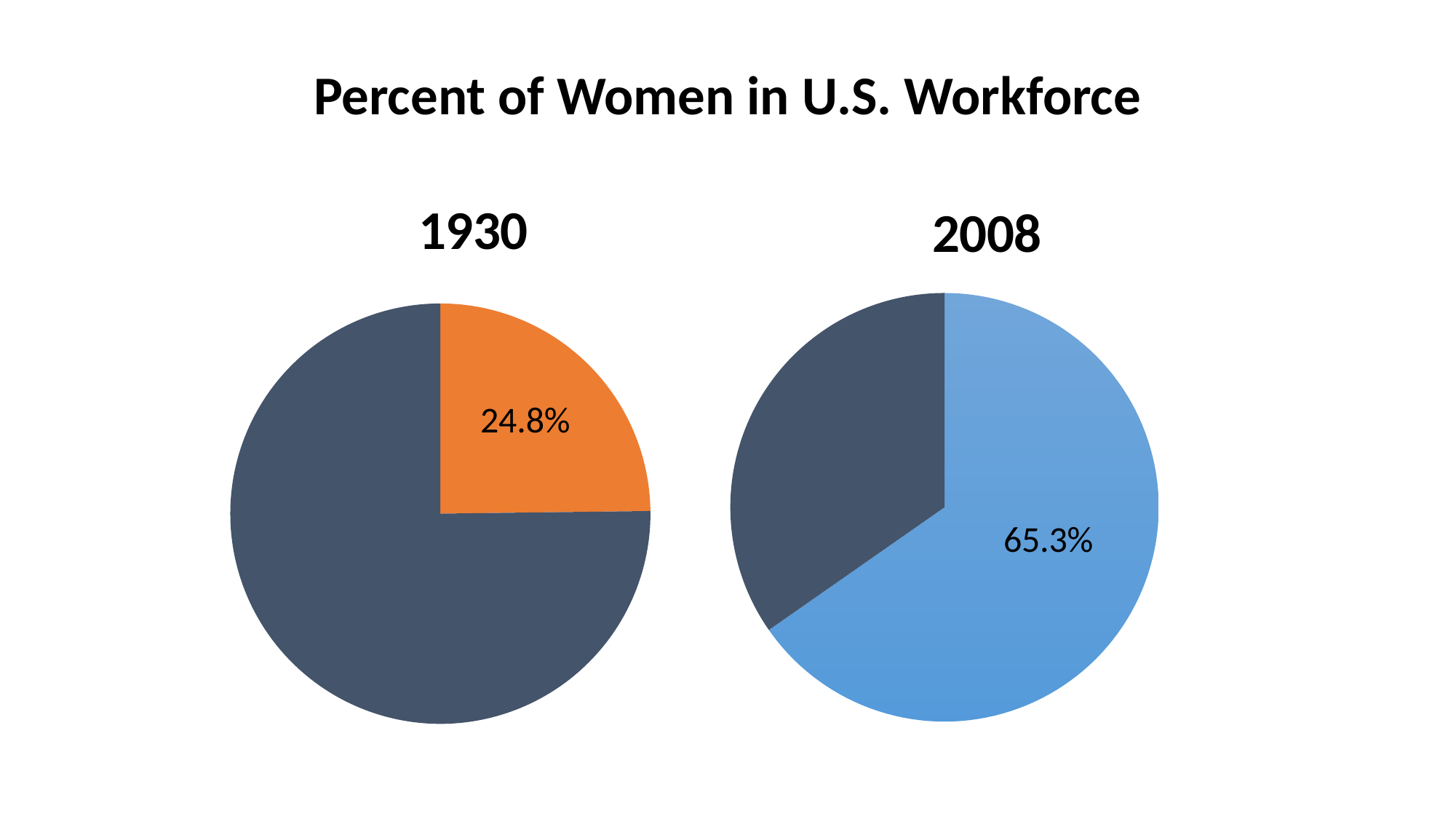
How many pie charts are on the slide? 2 What is the difference between the labeled percentage in the 2008 pie chart and the labeled percentage in the 1930 pie chart? 40.5% In the 1930 pie chart, what percentage is shown for the labeled slice? 24.8% What is the title of the slide's chart? Percent of Women in U.S. Workforce In the 1930 pie chart, what share of the pie does the unlabeled dark slice represent? 75.2% What kind of charts are shown on the slide? Pie charts How many slices does the 2008 pie chart have? 2 What colour is the labeled slice in the 1930 pie chart? Orange How many slices does the 1930 pie chart have? 2 Which year's pie chart shows the larger labeled percentage, 1930 or 2008? 2008 In the 2008 pie chart, what percentage is shown for the labeled slice? 65.3% Is the labeled value in the 2008 pie chart greater or less than 50%? greater